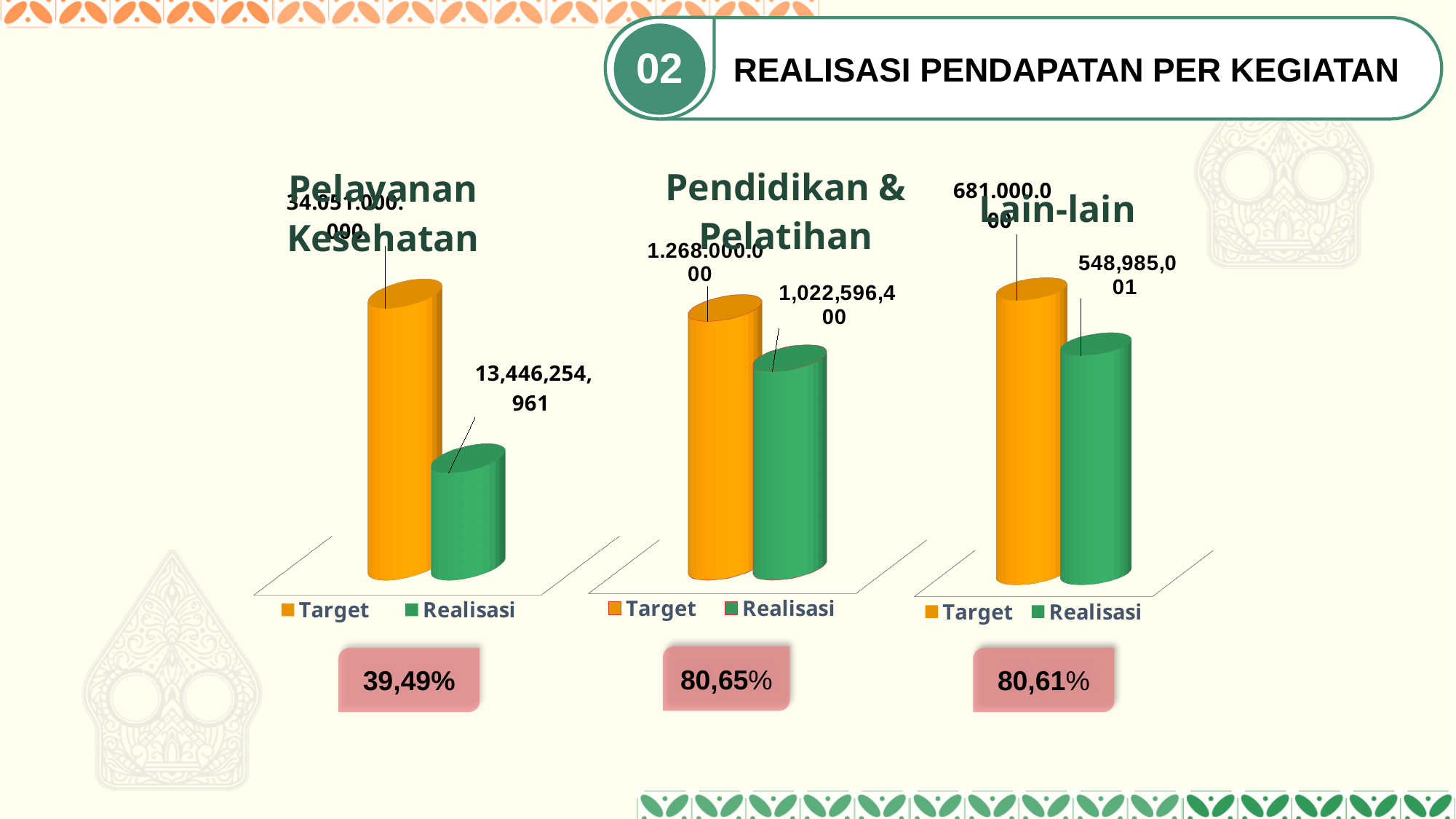
How many charts are shown on the slide? 3 In the Pendidikan & Pelatihan chart, what is the value of the Realisasi bar? 1,022,596,400 In the Pendidikan & Pelatihan chart, which series has the higher value? Target What kind of chart is the Lain-lain chart? Bar chart In the Pelayanan Kesehatan chart, what is the value of the Realisasi bar? 13,446,254,961 In the Pelayanan Kesehatan chart, which bar is taller, Target or Realisasi? Target In the Lain-lain chart, what is the value of the Realisasi bar? 548,985,001 In the Pendidikan & Pelatihan chart, what is the value of the Target bar? 1.268.000.000 In the Lain-lain chart, which series has the lower value? Realisasi In the Pelayanan Kesehatan chart, which colour represents the Realisasi series? Green How many series does the legend of the Pendidikan & Pelatihan chart list? 2 In the Lain-lain chart, what is the value of the Target bar? 681.000.000